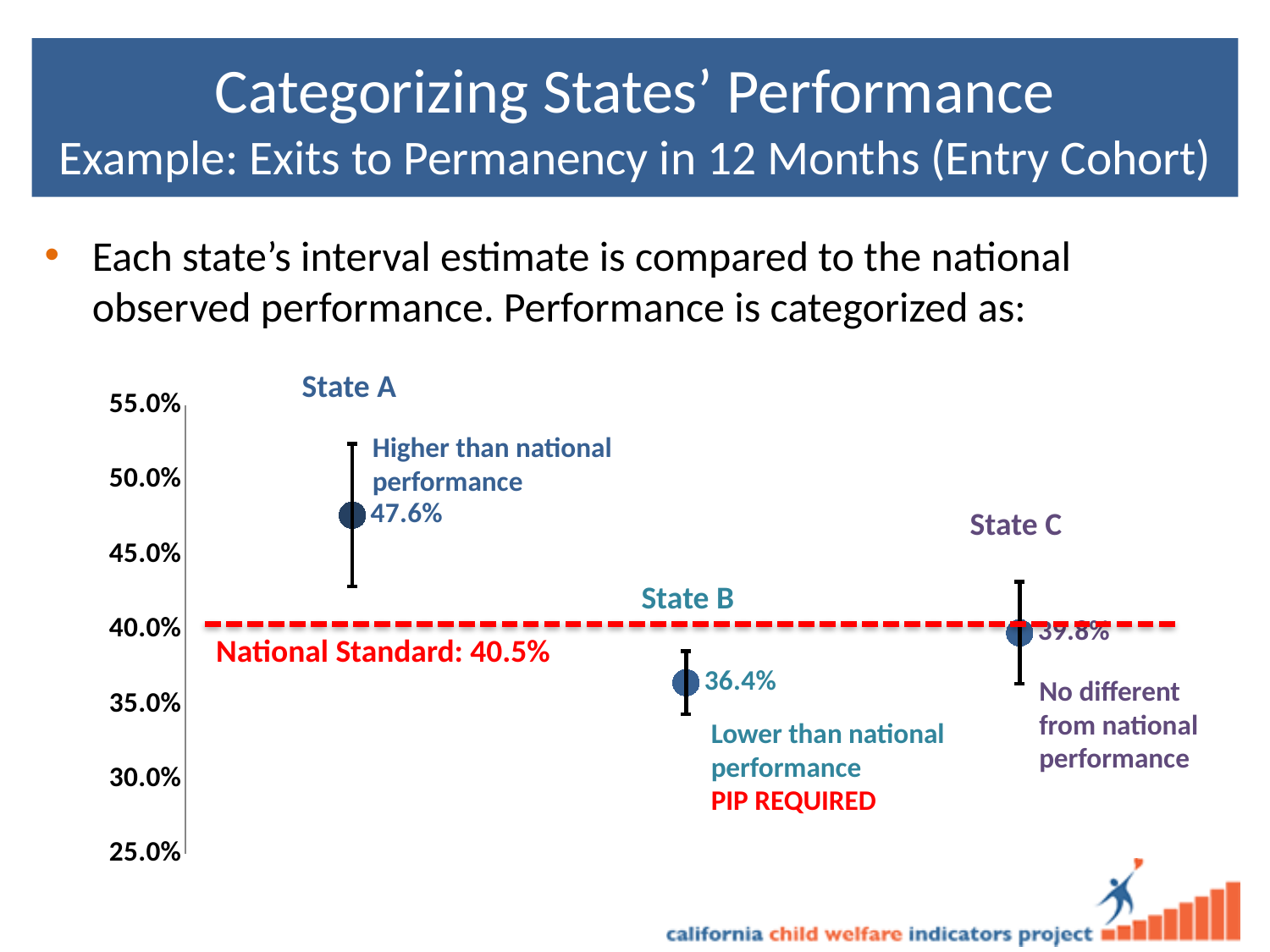
What is the difference between State A's and State B's point estimates? 11.2% What value is given for the National Standard line? 40.5% Is the point estimate for State A greater or less than 45.0%? greater What is the lowest value shown on the y-axis? 25.0% How is State B's performance categorized relative to national performance? Lower than national performance What is the point estimate shown for State B? 36.4% What is the point estimate shown for State A? 47.6% What is the point estimate shown for State C? 39.8% Which state has the highest point estimate? State A Which is larger, the point estimate for State C or for State B? State C How many states are plotted on the chart? 3 Which state has the lowest point estimate? State B